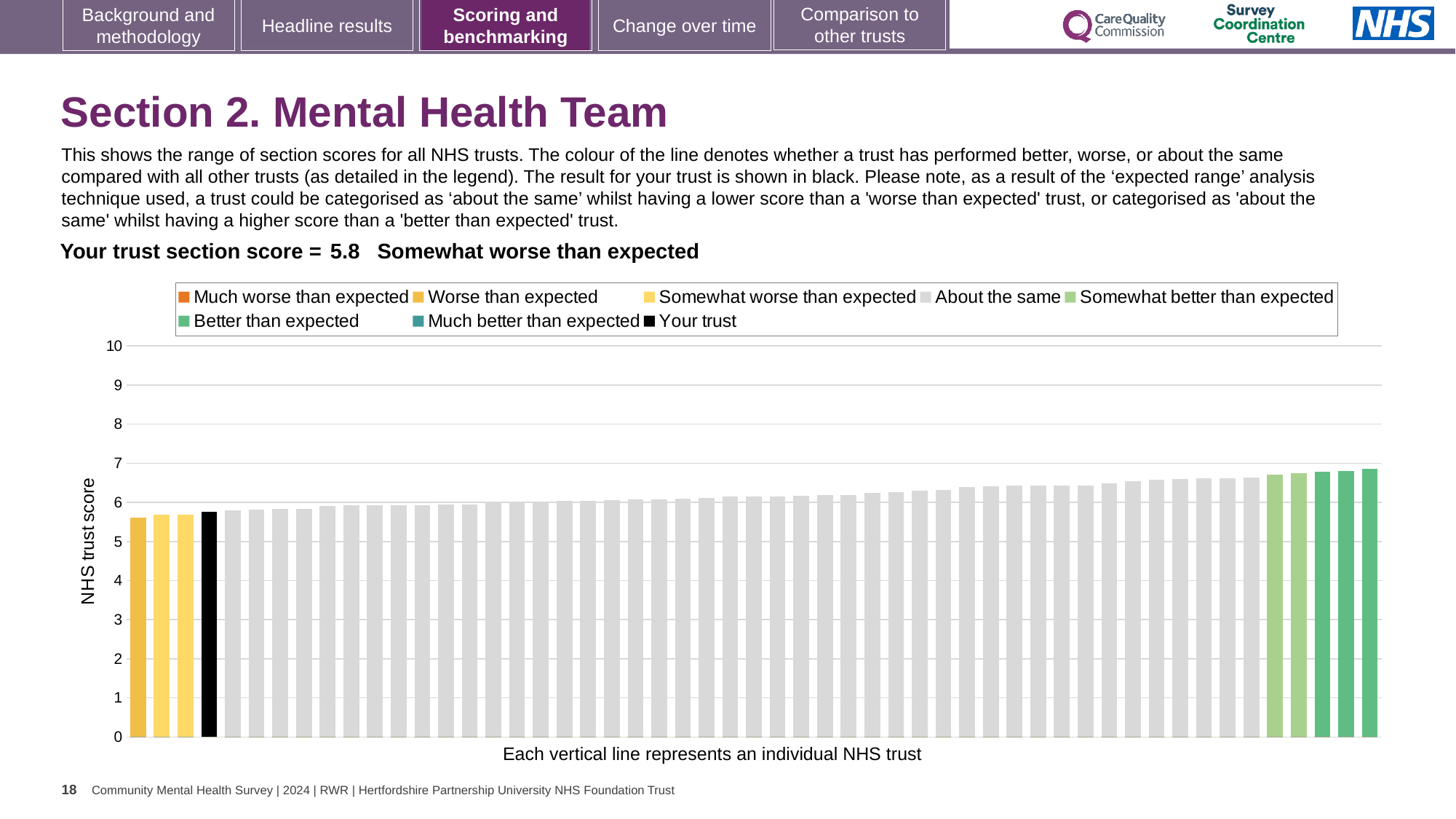
How many bars are positioned to the left of the black 'Your trust' bar? 3 What is the label on the vertical axis of the chart? NHS trust score Which benchmarking category is your trust placed in for this section? Somewhat worse than expected What is the section score for your trust shown on the slide? 5.8 What kind of chart is shown on the slide? bar chart How many entries does the chart legend list? 8 Is the value for your trust (the black bar) greater or less than 7? less Do the bar values rise or fall from left to right along the x axis? rise Is the value of the shortest bar greater or less than 5? greater Is the value for your trust (the black bar) greater or less than 5? greater